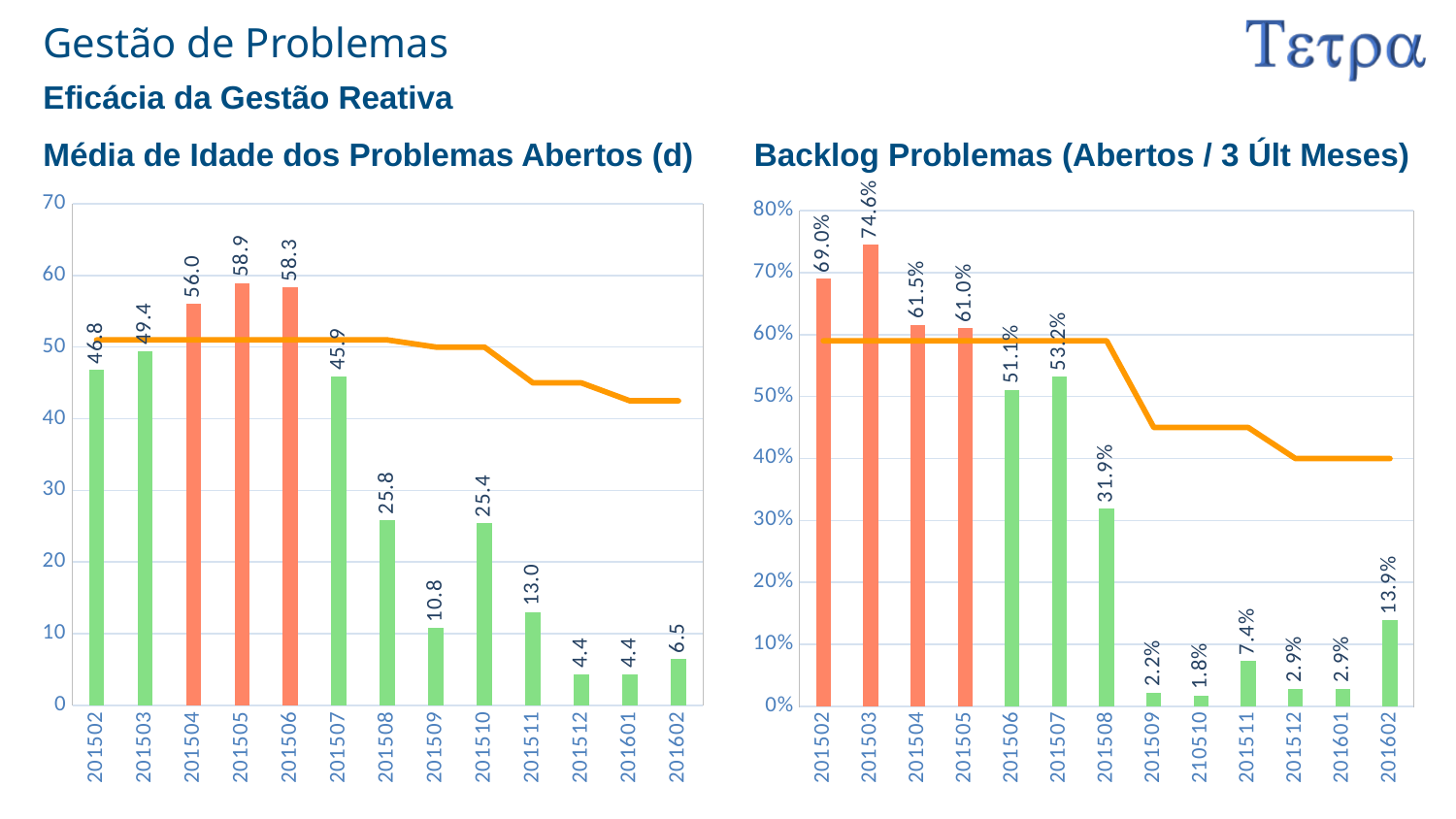
In the chart 'Média de Idade dos Problemas Abertos (d)', what colour are the bars for 201504, 201505 and 201506? Orange/red In the chart 'Backlog Problemas (Abertos / 3 Últ Meses)', what is the value for 201503? 74.6% In the chart 'Média de Idade dos Problemas Abertos (d)', how many periods are shown on the x axis? 13 In the chart 'Média de Idade dos Problemas Abertos (d)', which period has the highest value? 201505 In the chart 'Média de Idade dos Problemas Abertos (d)', which period has the lowest value? 201512 and 201601 (4.4) What kind of chart is 'Backlog Problemas (Abertos / 3 Últ Meses)'? Bar chart with a line In the chart 'Média de Idade dos Problemas Abertos (d)', is the value for 201507 greater or less than 40? greater In the chart 'Média de Idade dos Problemas Abertos (d)', what is the value for 201505? 58.9 In the chart 'Backlog Problemas (Abertos / 3 Últ Meses)', which is larger, the value for 201506 or 201507? 201507 In the chart 'Backlog Problemas (Abertos / 3 Últ Meses)', which period has the highest value? 201503 In the chart 'Backlog Problemas (Abertos / 3 Últ Meses)', what is the value for 201602? 13.9% In the chart 'Média de Idade dos Problemas Abertos (d)', what is the difference between the values for 201508 and 201509? 15.0